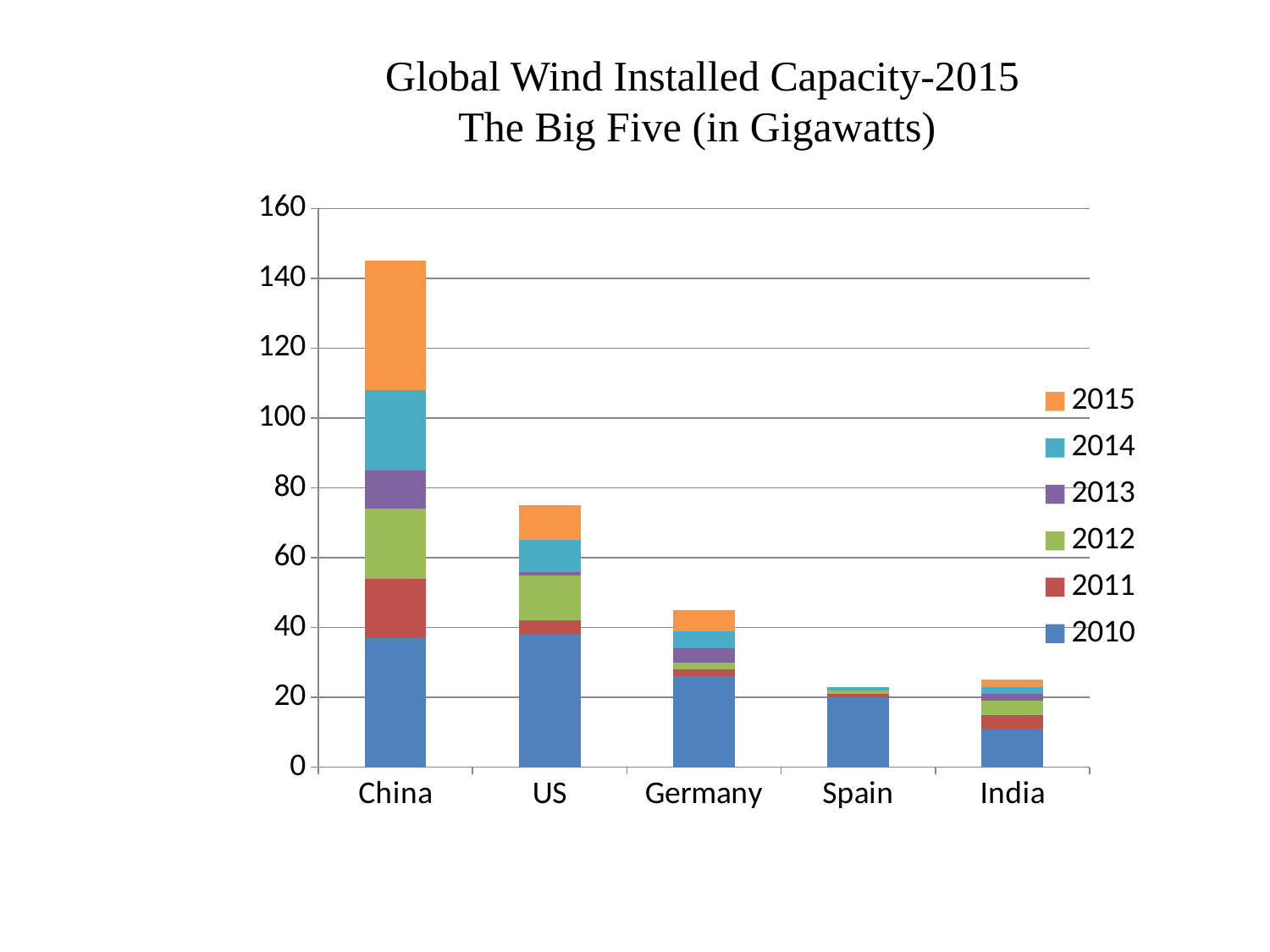
What is the title of the chart? Global Wind Installed Capacity-2015 The Big Five (in Gigawatts) How many countries are shown on the x axis of the chart? 5 Is the total stacked bar for Spain greater or less than 40? less Which has the larger total stacked bar, the US or Germany? US How many series does the legend list? 6 Is the total stacked bar for Germany greater or less than 40? greater Which country has the tallest stacked bar? China Is the total stacked bar for India greater or less than 40? less What kind of chart is shown on the slide? stacked bar chart Which year does the orange segment at the top of each bar represent, according to the legend? 2015